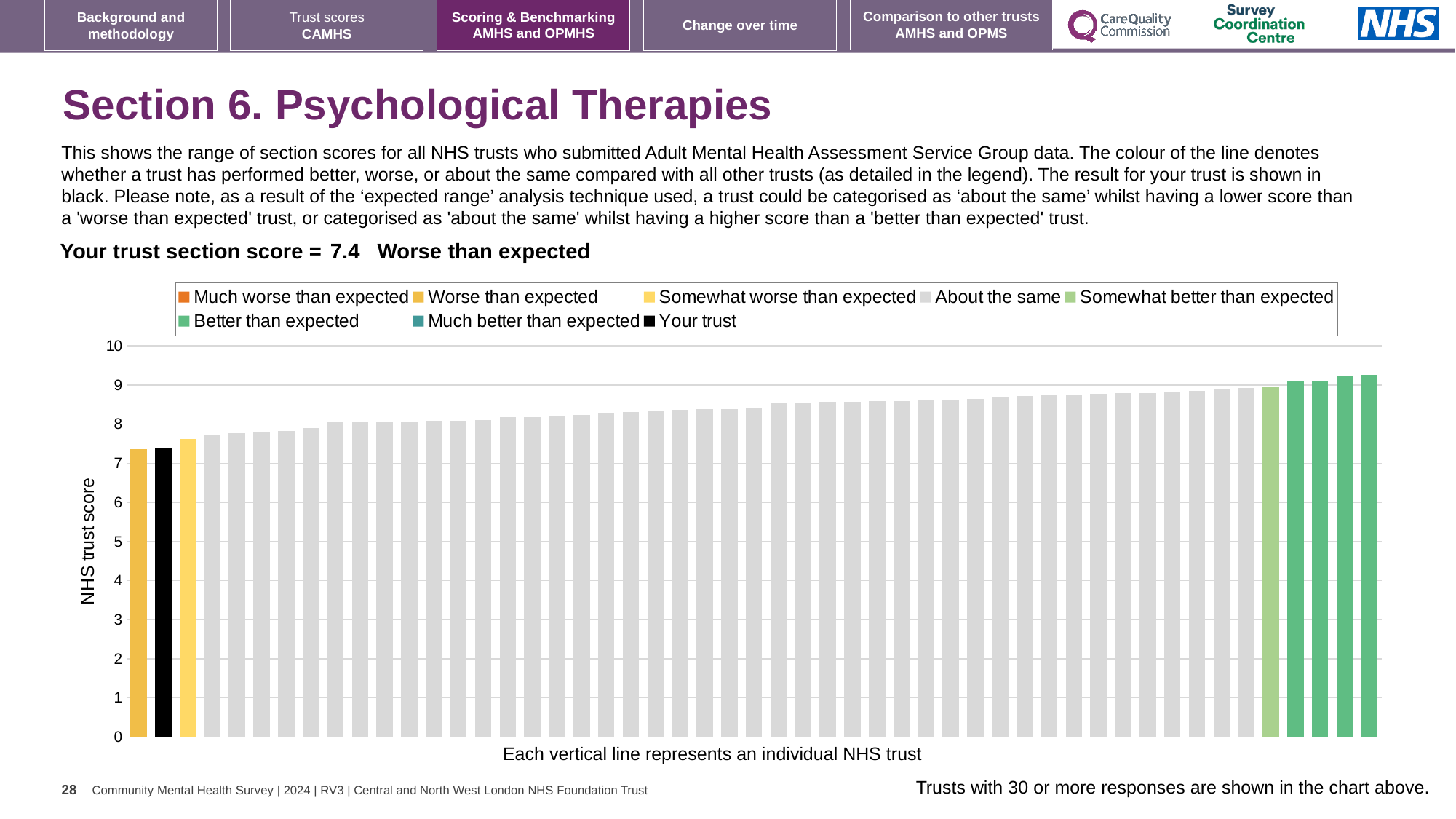
Is the value of the black 'Your trust' bar greater or less than 8? less Do the bar values rise or fall from left to right across the chart? Rise Is the value of the tallest bar in the chart greater or less than 9? greater Which legend category does the tallest bar in the chart belong to? Better than expected What is the section score for your trust shown on the slide? 7.4 How many bars are coloured as 'Somewhat better than expected' (light green) in the chart? 1 What is the label on the vertical axis of the chart? NHS trust score How many bars are coloured as 'Better than expected' (dark green) in the chart? 4 How many entries does the chart legend list? 8 What kind of chart is shown on the slide? Bar chart What category is your trust's section score placed in, according to the slide? Worse than expected Is the value of the leftmost bar in the chart greater or less than 8? less